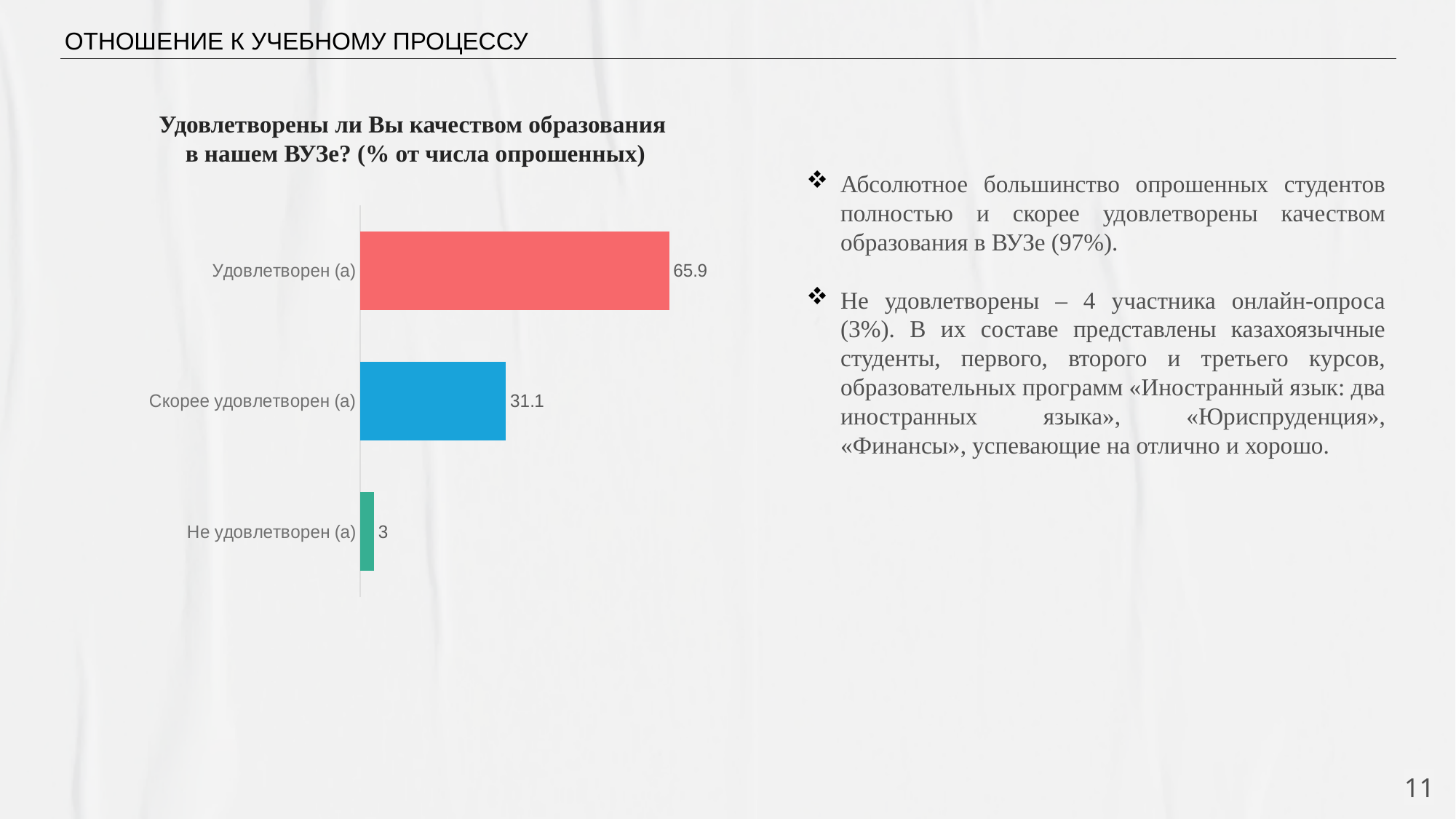
What is the value for Не удовлетворен (а)? 3 Which is larger, the value for Скорее удовлетворен (а) or the value for Не удовлетворен (а)? Скорее удовлетворен (а) What is the title of the chart? Удовлетворены ли Вы качеством образования в нашем ВУЗе? (% от числа опрошенных) How many categories are shown in the chart? 3 What is the value for Удовлетворен (а)? 65.9 What is the value for Скорее удовлетворен (а)? 31.1 What kind of chart is shown on the slide? bar chart What is the difference between the values for Удовлетворен (а) and Скорее удовлетворен (а)? 34.8 Which category has the highest value? Удовлетворен (а) What is the difference between the values for Скорее удовлетворен (а) and Не удовлетворен (а)? 28.1 What colour is the bar for Не удовлетворен (а)? green Which category has the lowest value? Не удовлетворен (а)